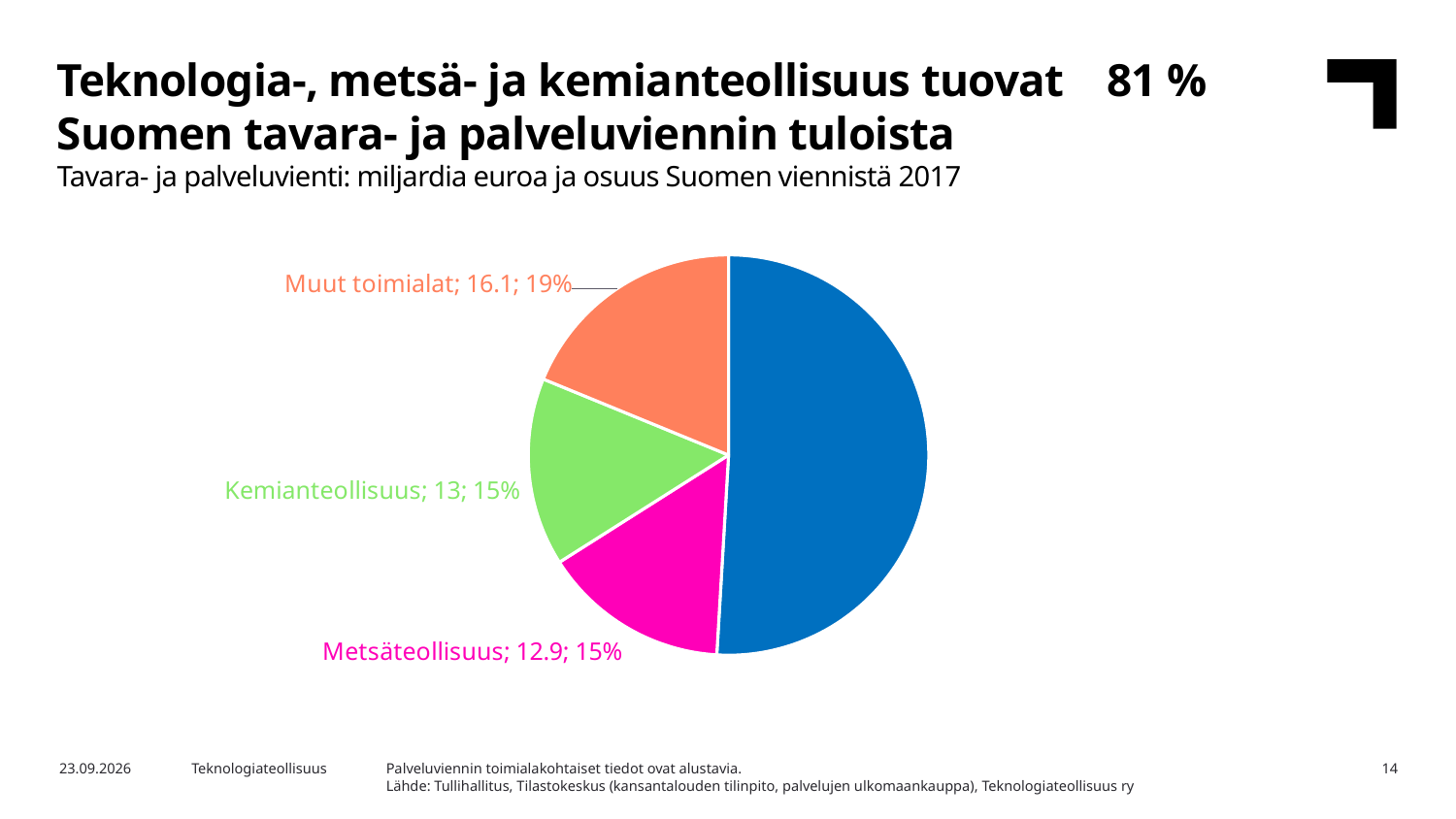
Which is larger, the value for Muut toimialat or the value for Kemianteollisuus? Muut toimialat How many slices does the pie chart have? 4 What share of the pie does Metsäteollisuus represent? 15% What kind of chart is shown on the slide? pie chart What value in billions of euros is shown for Kemianteollisuus? 13 What is the difference between the values for Muut toimialat and Metsäteollisuus? 3.2 What share of the pie does Muut toimialat represent? 19% What value in billions of euros is shown for Metsäteollisuus? 12.9 What colour is the Kemianteollisuus slice? green What value in billions of euros is shown for Muut toimialat? 16.1 Which of the labelled slices has the smallest value? Metsäteollisuus What is the difference between the values for Kemianteollisuus and Metsäteollisuus? 0.1